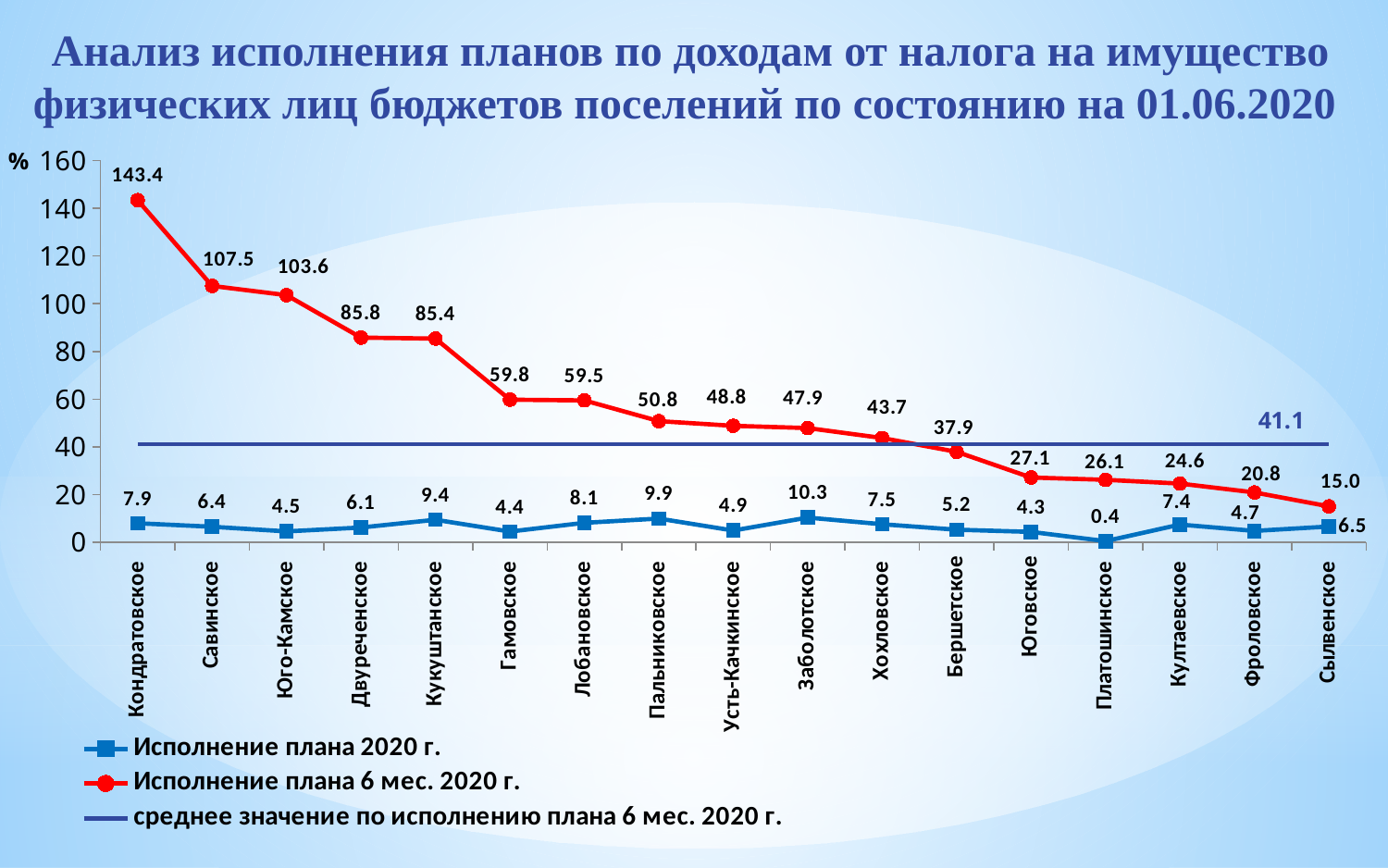
Which settlement has the highest value for 'Исполнение плана 2020 г.'? Заболотское Which settlement has the lowest value for 'Исполнение плана 6 мес. 2020 г.'? Сылвенское Which is larger for 'Исполнение плана 6 мес. 2020 г.': Хохловское or Бершетское? Хохловское How many settlements (categories) are shown on the x axis? 17 What is the value of the average line 'среднее значение по исполнению плана 6 мес. 2020 г.'? 41.1 Does the 'Исполнение плана 6 мес. 2020 г.' series rise or fall from left to right along the x axis? fall How many series does the legend list? 3 What is the value of 'Исполнение плана 2020 г.' for Заболотское? 10.3 What is the difference between the 'Исполнение плана 6 мес. 2020 г.' values for Савинское and Юго-Камское? 3.9 What type of chart is shown on the slide? line chart Which settlement has the lowest value for 'Исполнение плана 2020 г.'? Платошинское What is the value of 'Исполнение плана 6 мес. 2020 г.' for Кондратовское? 143.4